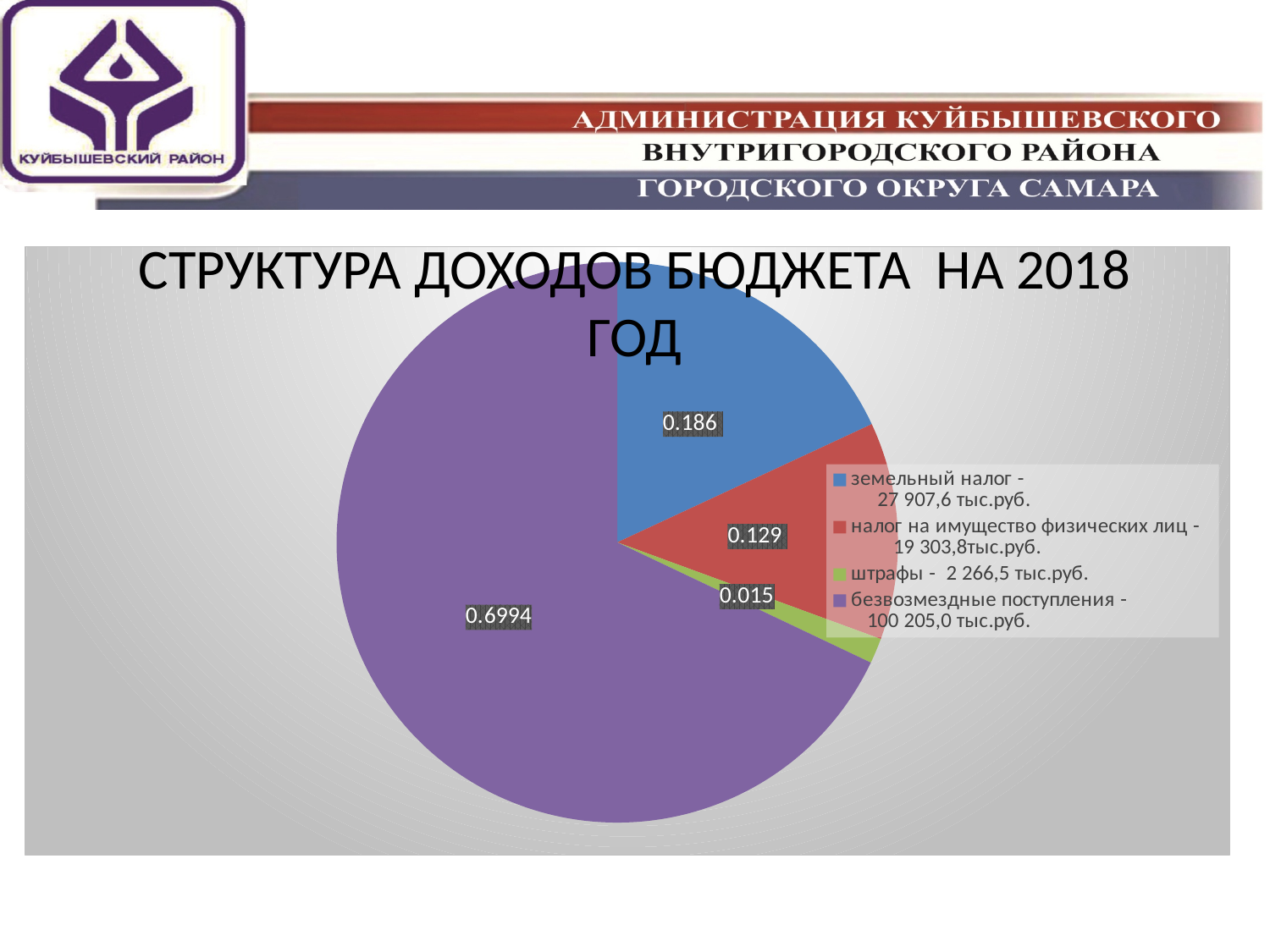
Which category has the largest slice of the pie? безвозмездные поступления Which category has the smallest slice of the pie? штрафы Which is larger, the slice for земельный налог or the slice for налог на имущество физических лиц? земельный налог What value is labelled on the slice for налог на имущество физических лиц? 0.129 What kind of chart is shown on the slide? pie chart What value is labelled on the slice for штрафы? 0.015 What value is labelled on the slice for земельный налог? 0.186 What is the title of the chart? СТРУКТУРА ДОХОДОВ БЮДЖЕТА НА 2018 ГОД What is the difference between the labelled values for земельный налог and налог на имущество физических лиц? 0.057 What value is labelled on the slice for безвозмездные поступления? 0.6994 According to the legend, what amount in тыс.руб. is given for штрафы? 2 266,5 тыс.руб. How many slices does the pie chart have? 4